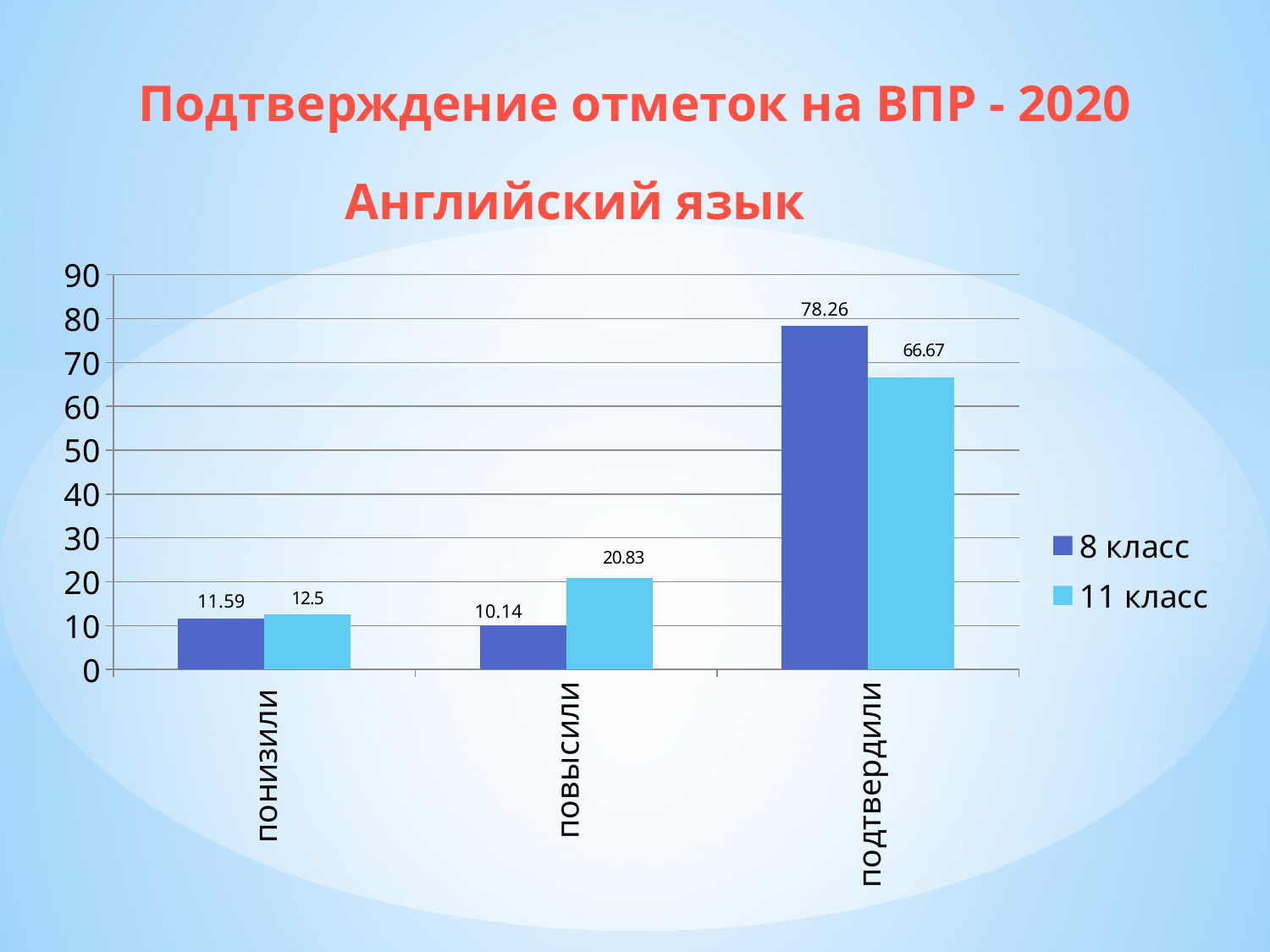
What is the difference between the 8 класс and 11 класс values in the подтвердили category? 11.59 Which category has the lowest value for 8 класс? повысили How many series does the legend list? 2 What is the value for 8 класс in the понизили category? 11.59 What kind of chart is shown on the slide? bar chart What is the value for 8 класс in the подтвердили category? 78.26 In the повысили category, which series has the larger value, 8 класс or 11 класс? 11 класс How many categories are shown on the x axis? 3 What is the value for 11 класс in the повысили category? 20.83 Is the value for 11 класс in the подтвердили category greater or less than 60? greater Which category has the highest value for 11 класс? подтвердили What is the value for 11 класс in the понизили category? 12.5